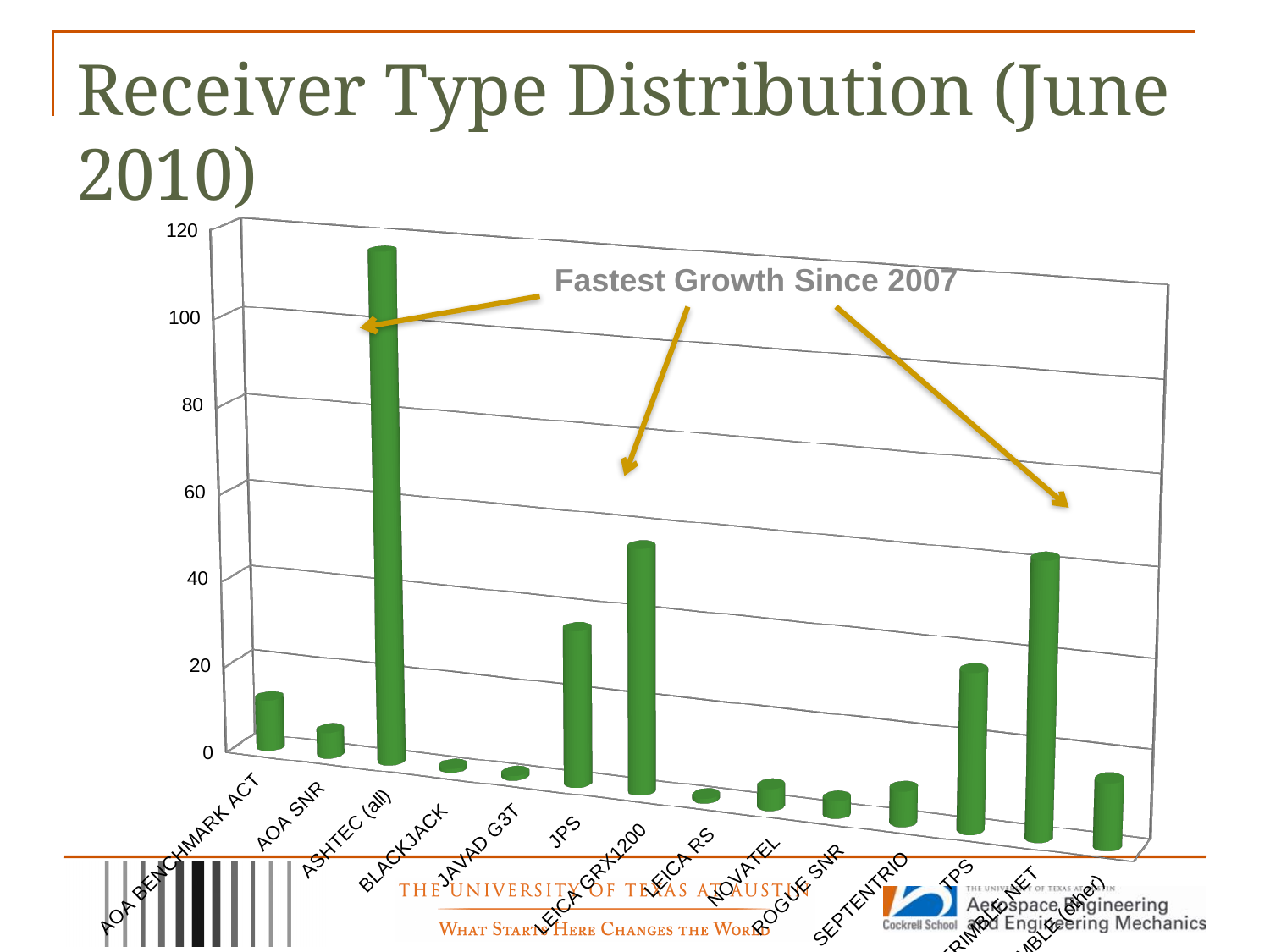
What text does the annotation with the arrows on the chart say? Fastest Growth Since 2007 Which is larger, the value for JPS or the value for LEICA GRX1200? LEICA GRX1200 Is the value for LEICA GRX1200 greater or less than 40? greater What kind of chart is shown on the slide? bar chart Is the value for BLACKJACK greater or less than 20? less How many receiver types (bars) are plotted in the chart? 14 Which is larger, the value for AOA BENCHMARK ACT or the value for AOA SNR? AOA BENCHMARK ACT What is the title of the slide containing the chart? Receiver Type Distribution (June 2010) Is the value for ASHTEC (all) greater or less than 100? greater Which receiver type has the highest bar? ASHTEC (all)